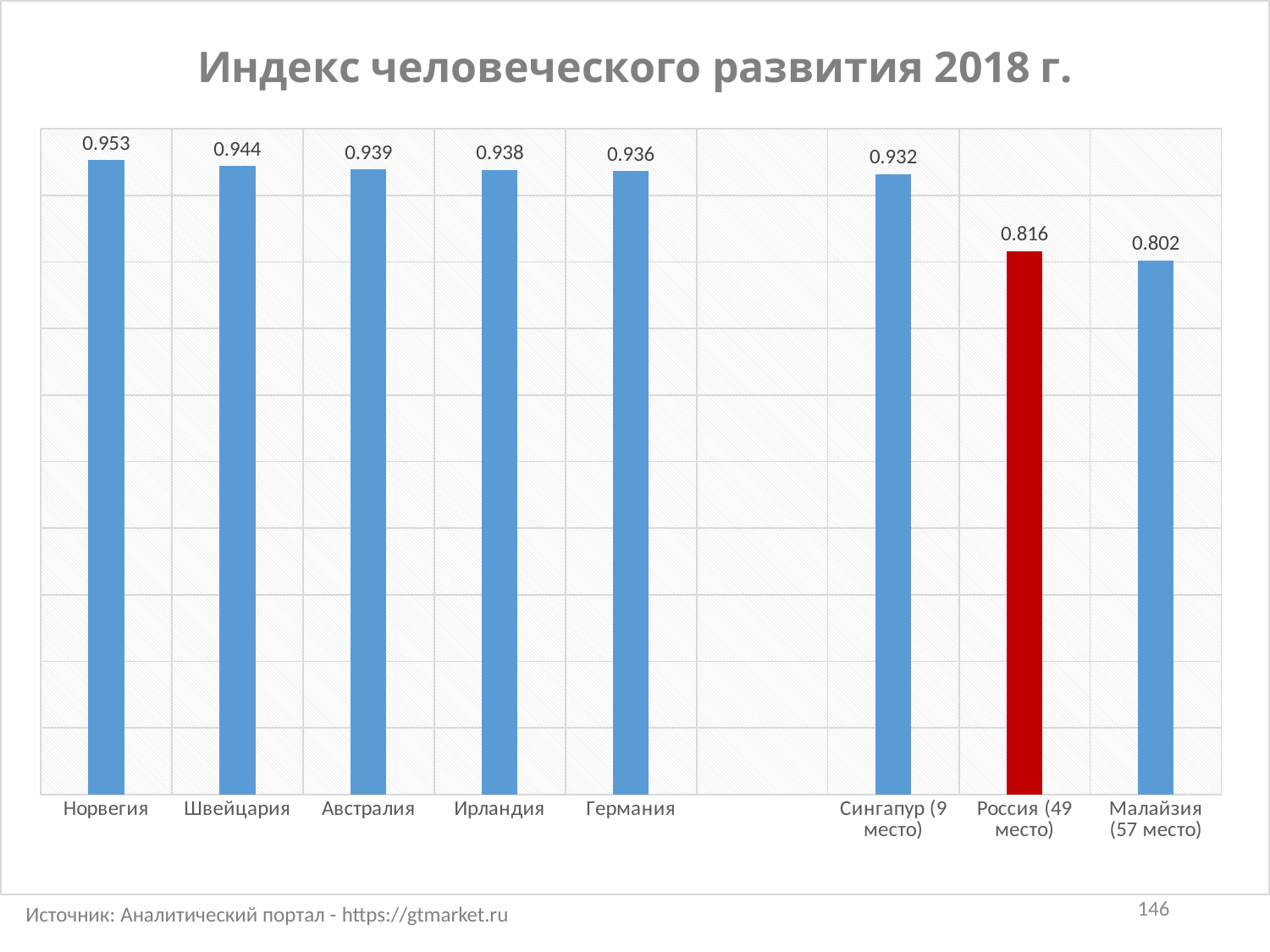
Which country has the lowest value? Малайзия (57 место) What kind of chart is shown? Bar chart Which country has the highest value? Норвегия How many countries have bars in the chart? 8 What is the value for Малайзия (57 место)? 0.802 What is the difference between the values for Норвегия and Россия (49 место)? 0.137 What is the value for Сингапур (9 место)? 0.932 Which country's bar is coloured red? Россия (49 место) What is the value for Россия (49 место)? 0.816 What is the difference between the values for Россия (49 место) and Малайзия (57 место)? 0.014 What is the value for Норвегия? 0.953 Which is larger, the value for Сингапур (9 место) or the value for Россия (49 место)? Сингапур (9 место)